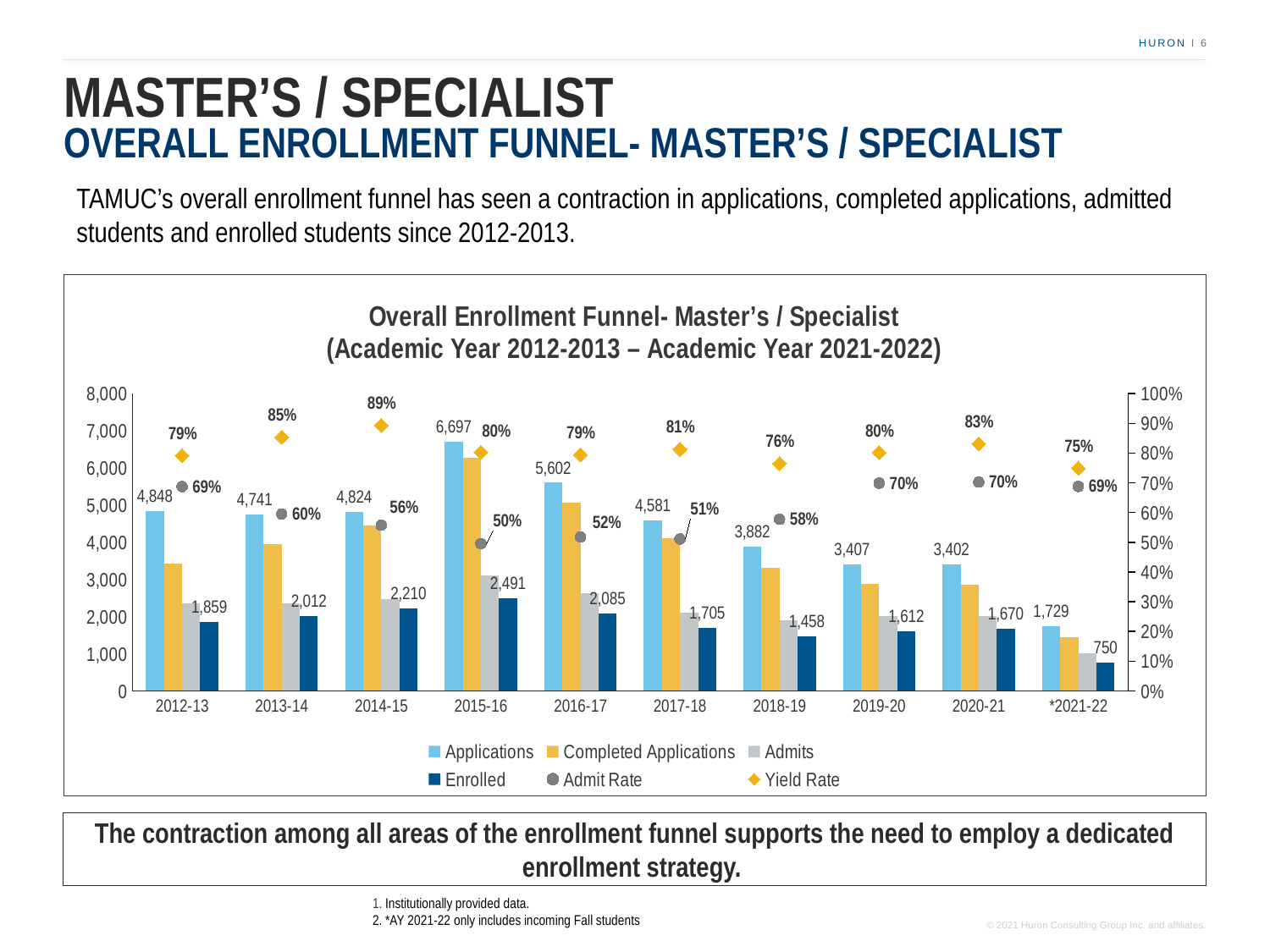
How many series does the legend list? 6 What is the Yield Rate for 2020-21? 83% Which year had more Enrolled students, 2014-15 or 2016-17? 2014-15 What is the Enrolled value for *2021-22? 750 What is the difference between Applications in 2012-13 and Applications in *2021-22? 3,119 What is the number of Applications for 2015-16? 6,697 How many academic years are shown on the x axis? 10 In which academic year is the Yield Rate highest? 2014-15 In which academic year is the Admit Rate lowest? 2015-16 Do Applications rise or fall from 2015-16 to *2021-22? fall Is the value for Admits in 2012-13 greater or less than 2,000? greater What kind of chart is this? combination bar and line chart